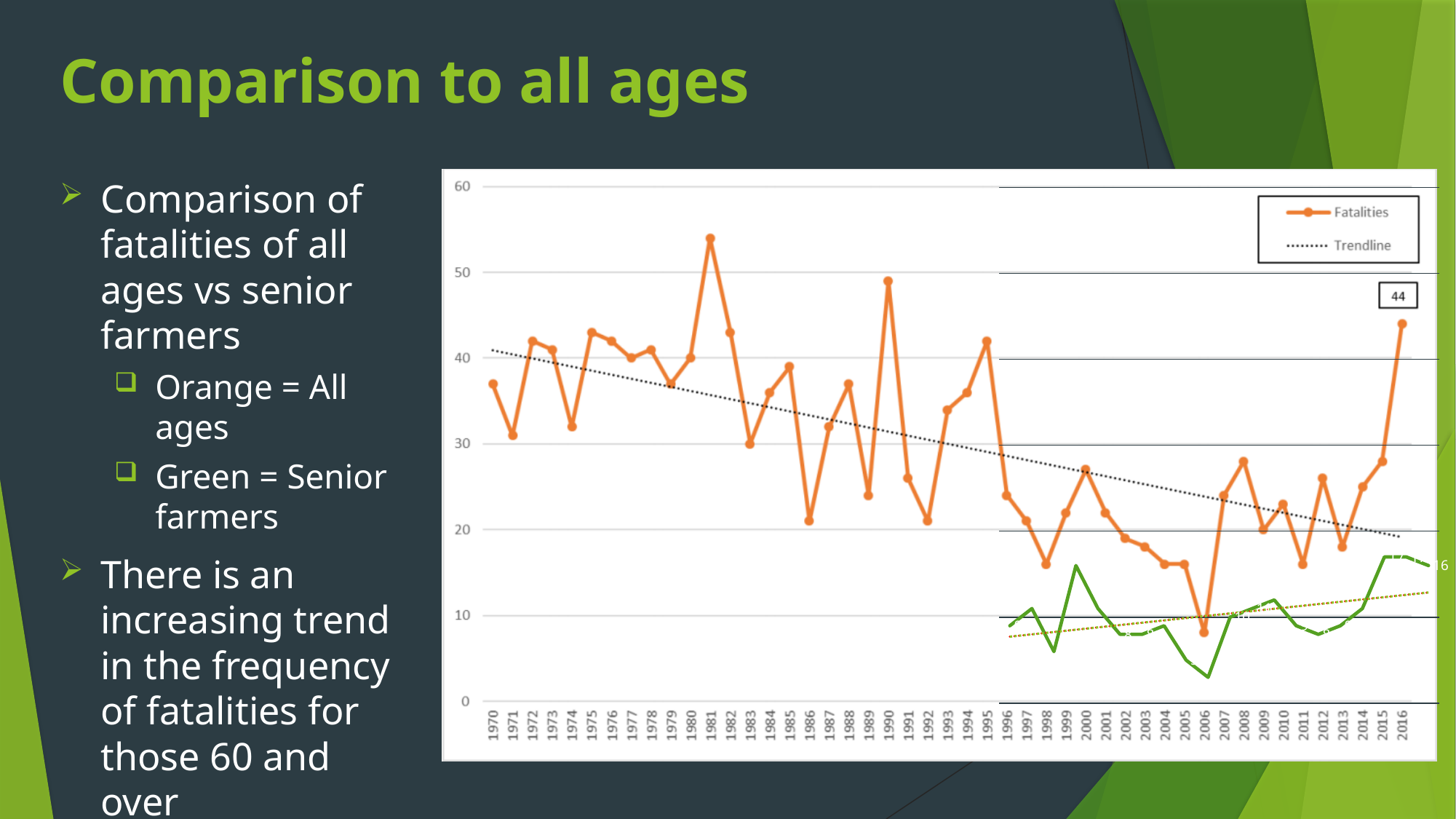
What is the Fatalities value for 2016? 44 Does the dotted Trendline for Fatalities rise or fall from 1970 to 2016? fall How many series does the chart legend list? 2 Which year has the lowest Fatalities value on the orange line? 2006 Is the Fatalities value for 1981 greater or less than 50? greater Is the Fatalities value for 1970 greater or less than 40? less What colour is the Fatalities line in the chart? orange What kind of chart is shown on the slide? line chart Which year has the larger Fatalities value, 2015 or 2016? 2016 Is the Fatalities value for 2006 greater or less than 10? less Which year has the larger Fatalities value, 1981 or 1990? 1981 Which year has the highest Fatalities value on the orange line? 1981